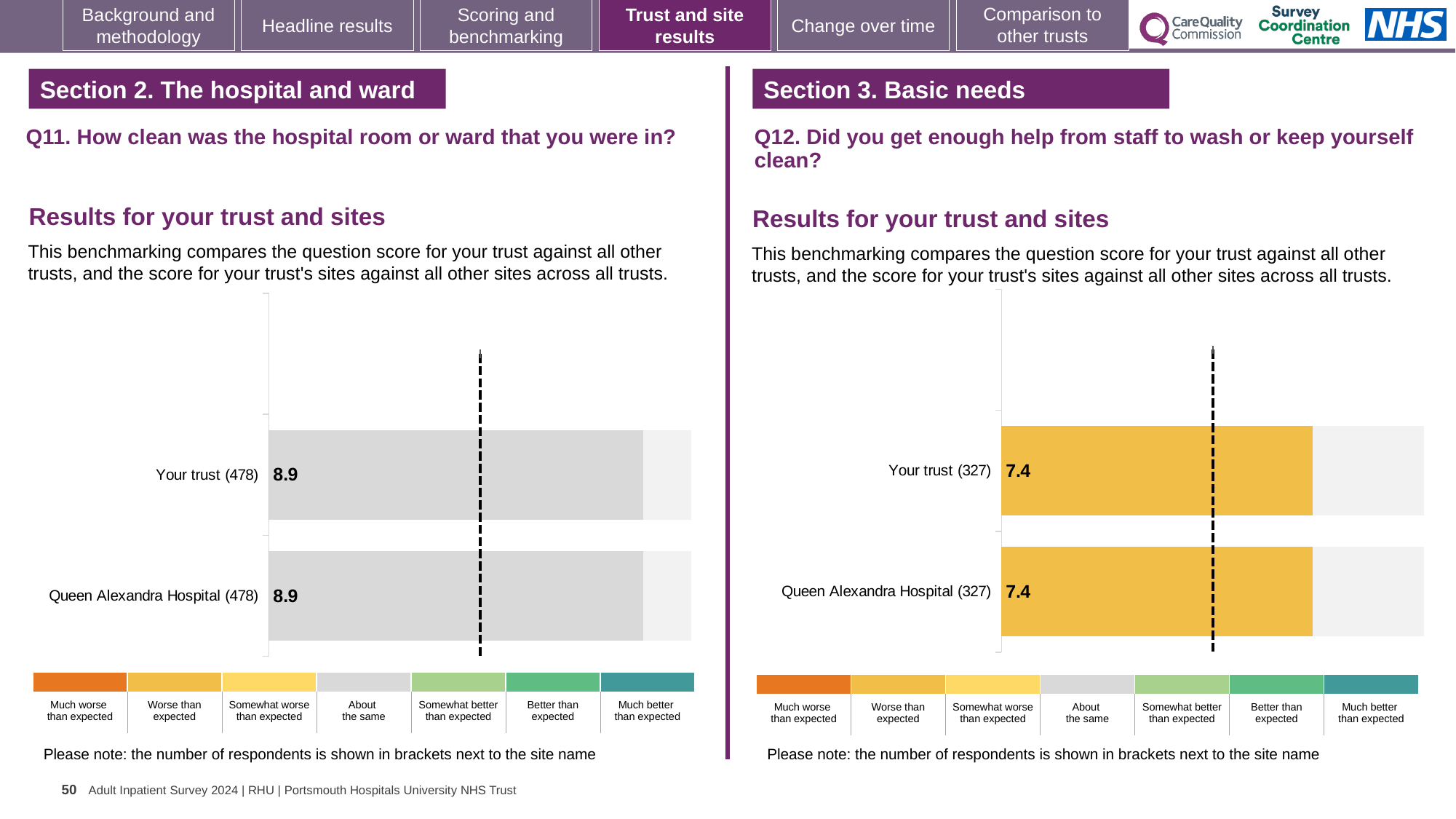
In the Q11 chart on the left, what is the score for Queen Alexandra Hospital? 8.9 What kind of chart is used for the Q12 results on the right? Bar chart In the Q12 chart on the right, what is the score for Queen Alexandra Hospital? 7.4 How many bars are plotted in the Q11 chart on the left? 2 In the Q11 chart on the left, what is the score for Your trust? 8.9 In the Q11 chart on the left, how many respondents are shown in brackets for Your trust? 478 In the Q11 chart on the left, what is the difference between the score for Your trust and the score for Queen Alexandra Hospital? 0.0 In the Q12 chart on the right, what is the score for Your trust? 7.4 In the Q12 chart on the right, how many respondents are shown in brackets for Queen Alexandra Hospital? 327 How many bars are plotted in the Q12 chart on the right? 2 In the Q12 chart on the right, what is the difference between the score for Your trust and the score for Queen Alexandra Hospital? 0.0 In the Q12 chart on the right, which benchmark category does the colour of the bars correspond to according to the legend? Worse than expected